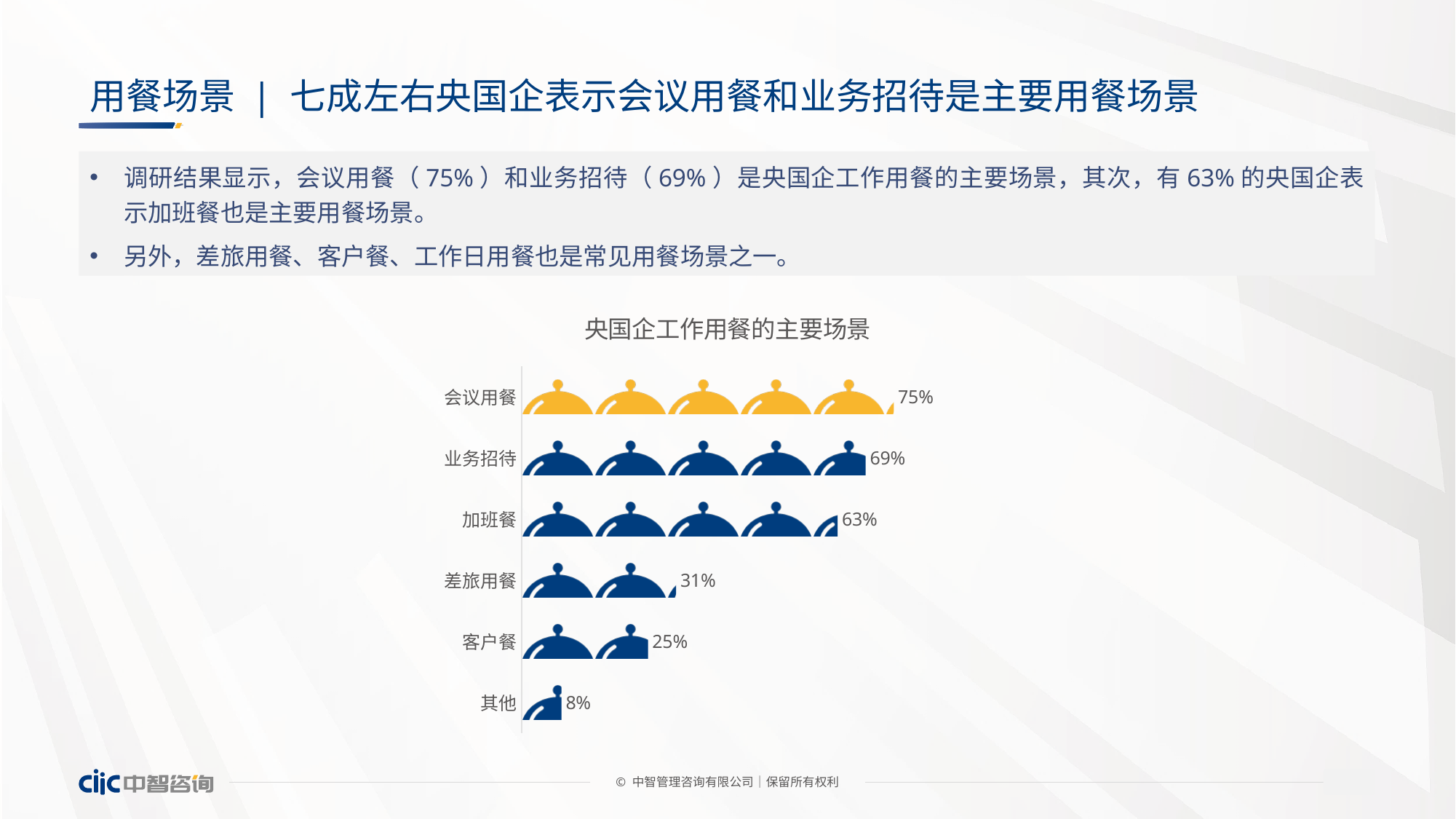
What is the value for 客户餐? 25% What is the difference between the values for 会议用餐 and 业务招待? 6% What is the value for 会议用餐 in the chart 央国企工作用餐的主要场景? 75% What is the value for 加班餐? 63% Which category has the lowest value? 其他 Which is larger, the value for 差旅用餐 or 客户餐? 差旅用餐 How many categories are shown in the chart? 6 Which category has the highest value? 会议用餐 What is the value for 其他? 8% What is the value for 业务招待? 69% What is the value for 差旅用餐? 31% What is the title of the chart? 央国企工作用餐的主要场景